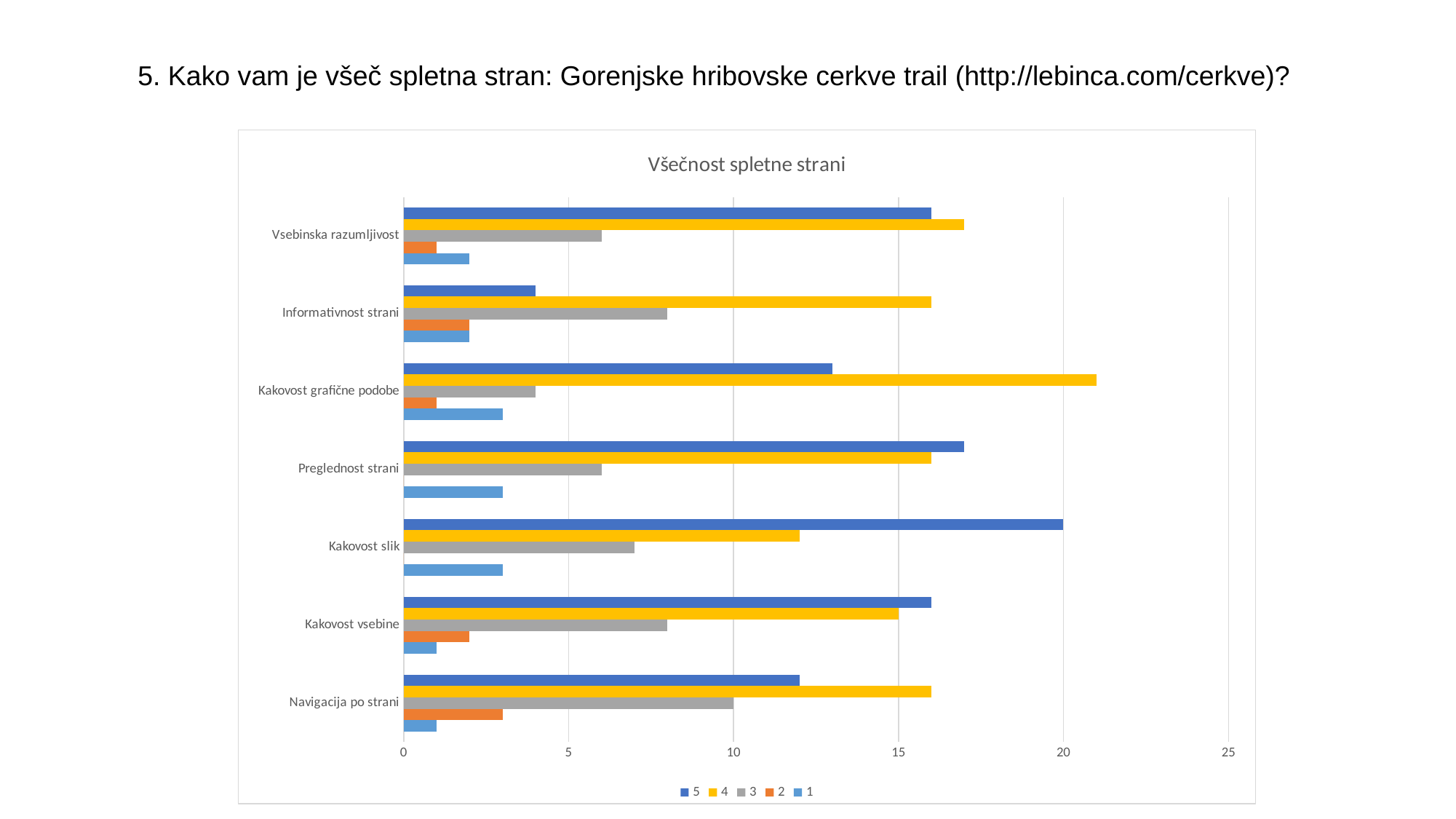
For Kakovost slik, which is larger: series 5 or series 4? series 5 Is the value of series 5 for Informativnost strani greater or less than 5? less Is the value of series 4 for Kakovost grafične podobe greater or less than 20? greater What is the title of the chart? Všečnost spletne strani What is the value of series 4 for Kakovost vsebine? 15 How many series does the legend list? 5 What is the value of series 5 for Kakovost slik? 20 Which category has the lowest value for series 5? Informativnost strani How many categories are shown on the vertical axis? 7 Which category has the highest value for series 5? Kakovost slik What kind of chart is shown on the slide? bar chart What is the value of series 3 for Navigacija po strani? 10